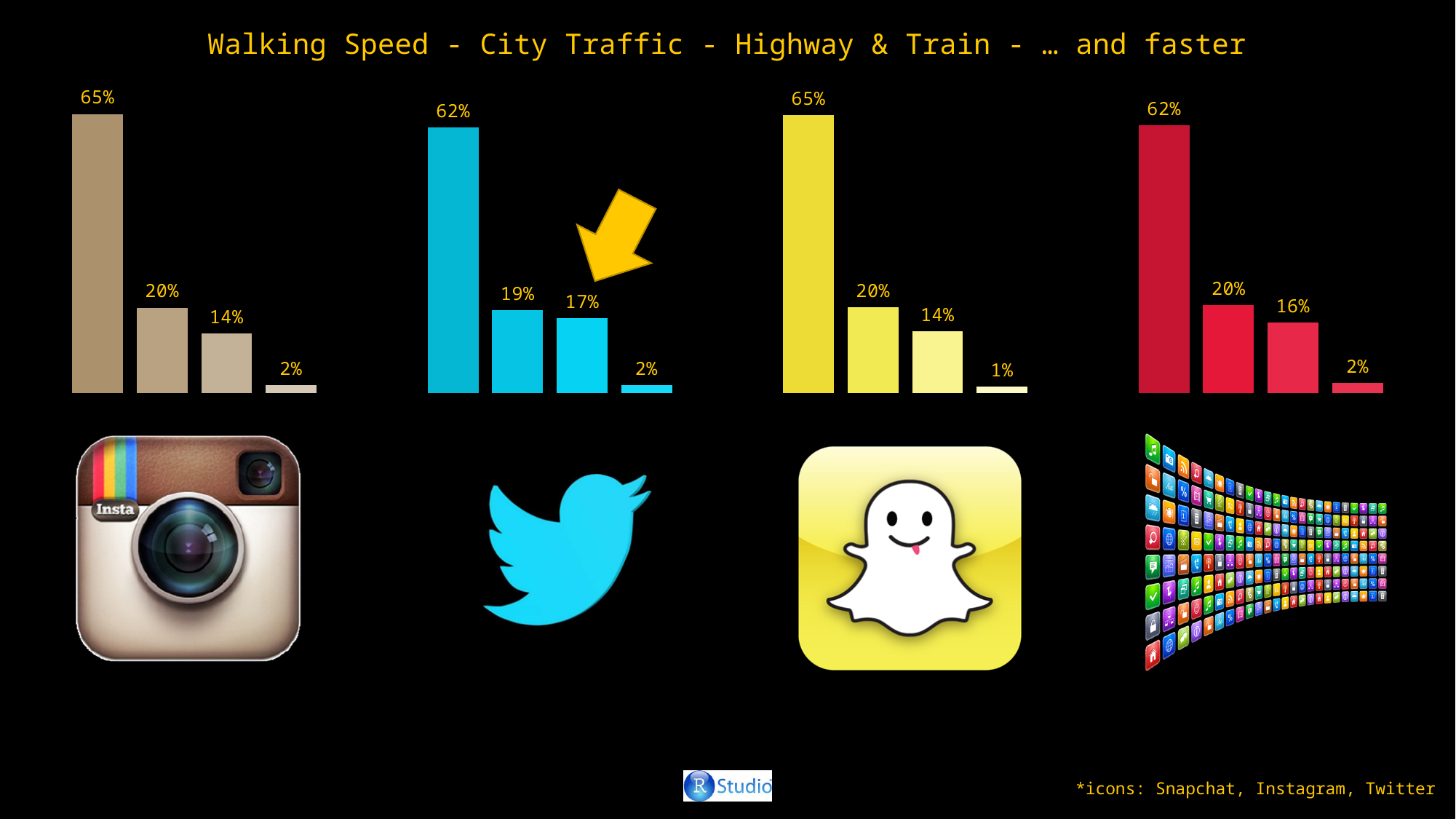
In the second chart from the left (above the Twitter icon), what value does the bar marked by the orange arrow show? 17% Which is larger: the third bar in the second chart from the left (Twitter) or the third bar in the rightmost chart? The third bar in the second chart (17%) What type of chart is used for each of the four charts on the slide? Bar chart In the rightmost chart (above the app-icon grid), what is the value of the third bar? 16% In the leftmost chart, what is the difference between the first bar (65%) and the second bar (20%)? 45% What is the title shown at the top of the slide? Walking Speed - City Traffic - Highway & Train - … and faster In the rightmost chart, what is the value of the first bar? 62% In the leftmost chart (above the Instagram icon), what is the value of the first (tallest) bar? 65% In the third chart from the left (Snapchat), do the bar values rise or fall from left to right? Fall In the second chart from the left, what is the difference between the second bar (19%) and the third bar (17%)? 2% How many bars does each of the four charts on the slide contain? 4 In the third chart from the left (above the Snapchat icon), what is the value of the fourth (smallest) bar? 1%